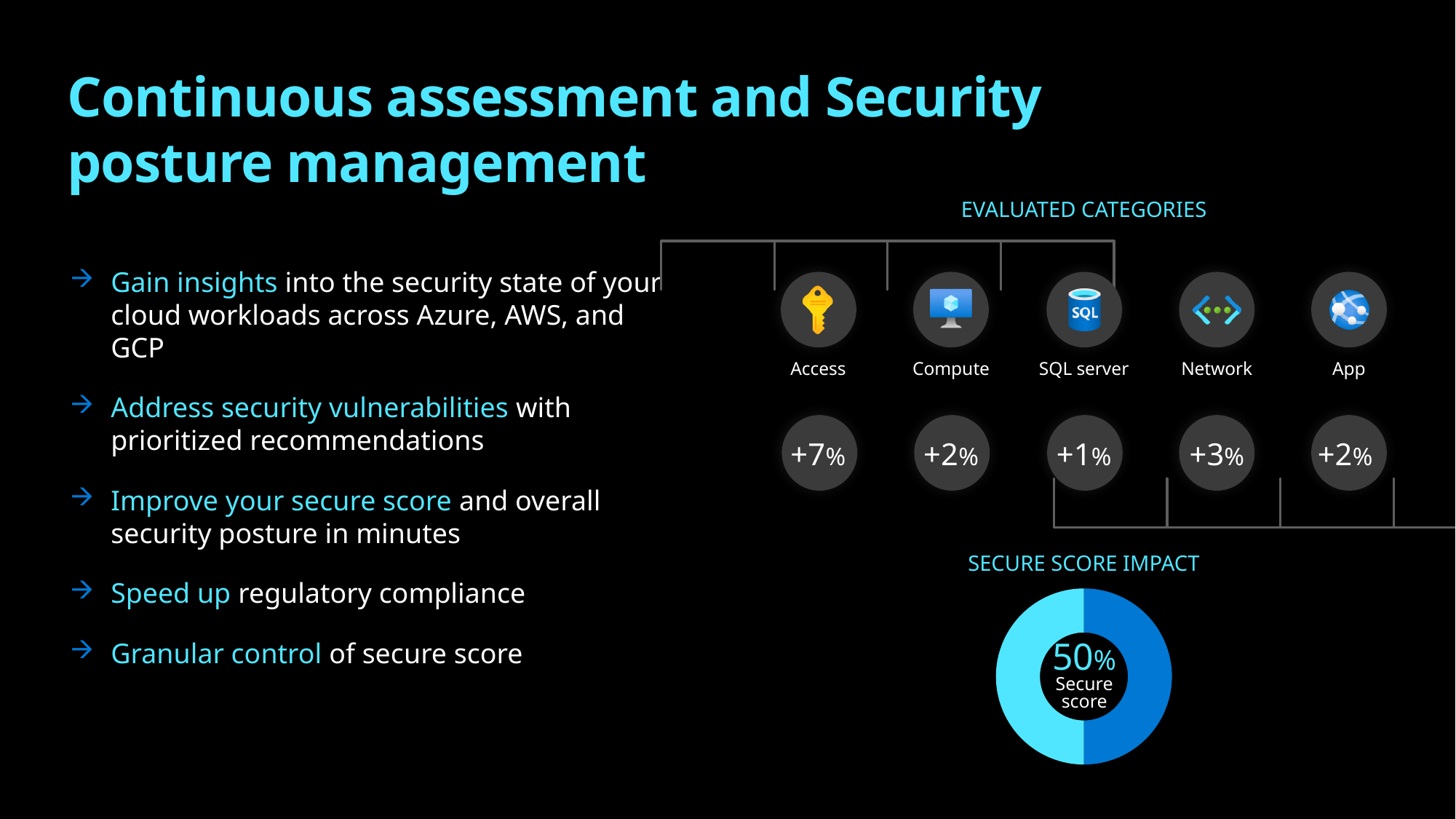
What secure score value is printed in the centre of the SECURE SCORE IMPACT donut chart? 50% In the EVALUATED CATEGORIES section, which category has the lowest secure score impact? SQL server What share of the SECURE SCORE IMPACT donut does the filled secure score portion represent? 50% In the EVALUATED CATEGORIES section, how many categories are shown? 5 In the EVALUATED CATEGORIES section, which category has the highest secure score impact? Access In the EVALUATED CATEGORIES section, what is the secure score impact shown for Network? +3% What kind of chart is shown under the heading SECURE SCORE IMPACT? donut chart In the EVALUATED CATEGORIES section, what is the secure score impact shown for Access? +7% In the EVALUATED CATEGORIES section, which has a larger secure score impact, Network or Compute? Network How many slices does the SECURE SCORE IMPACT donut chart have? 2 What heading appears directly above the donut chart? SECURE SCORE IMPACT In the EVALUATED CATEGORIES section, what is the difference between the secure score impact for Access and for Network? 4%